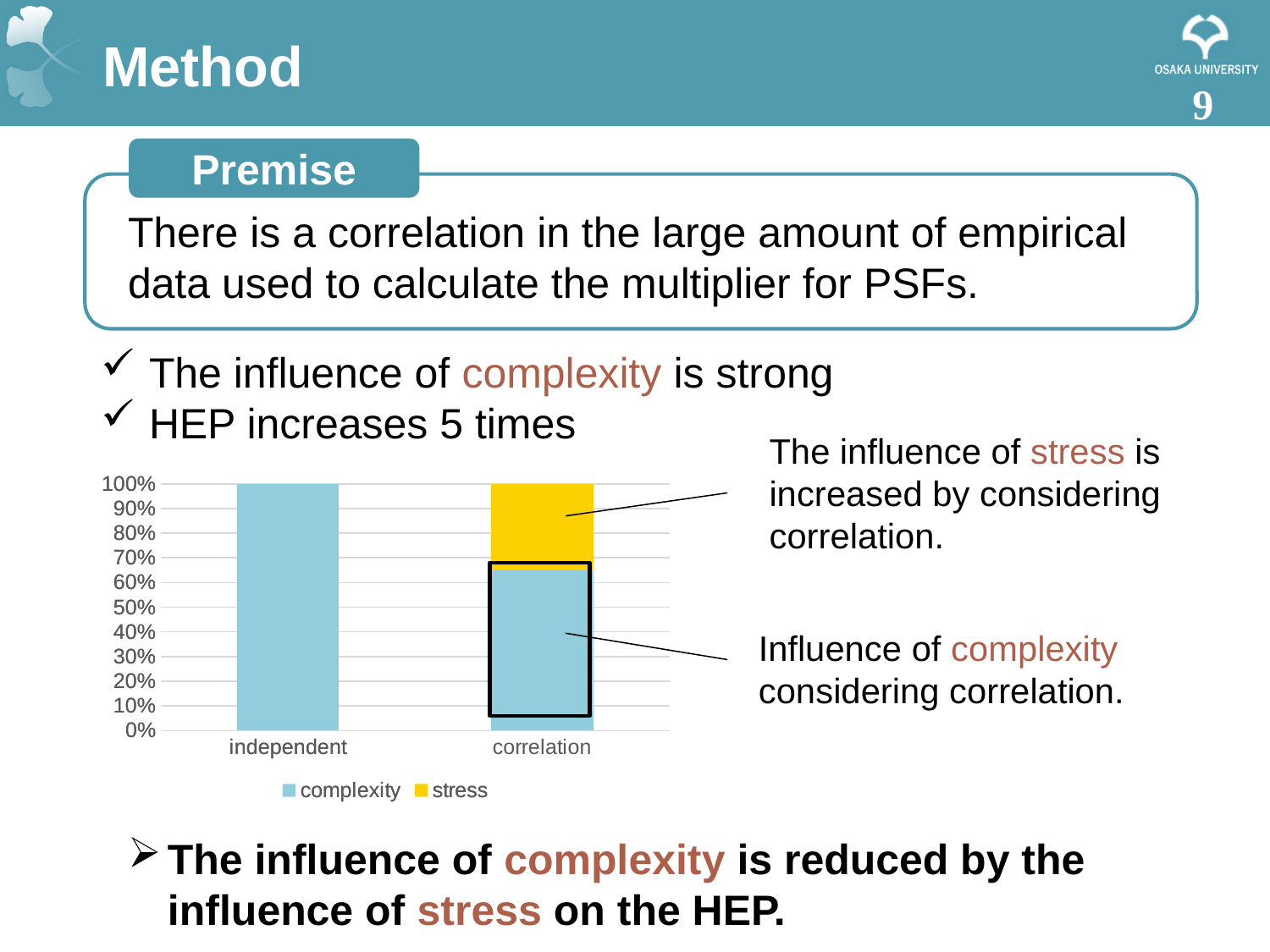
How many categories are shown on the x axis of the chart? 2 Which colour represents the stress series in the chart? yellow Which category has the larger complexity share, independent or correlation? independent Is the complexity value for the correlation category greater or less than 80%? less Which category has the larger stress share, independent or correlation? correlation Which series are listed in the chart legend? complexity and stress What is the value of complexity for the independent category? 100% Is the complexity value for the correlation category greater or less than 60%? greater What kind of chart is shown on the slide? stacked bar chart Is the stress share in the correlation bar greater or less than 20%? greater How many series does the chart legend list? 2